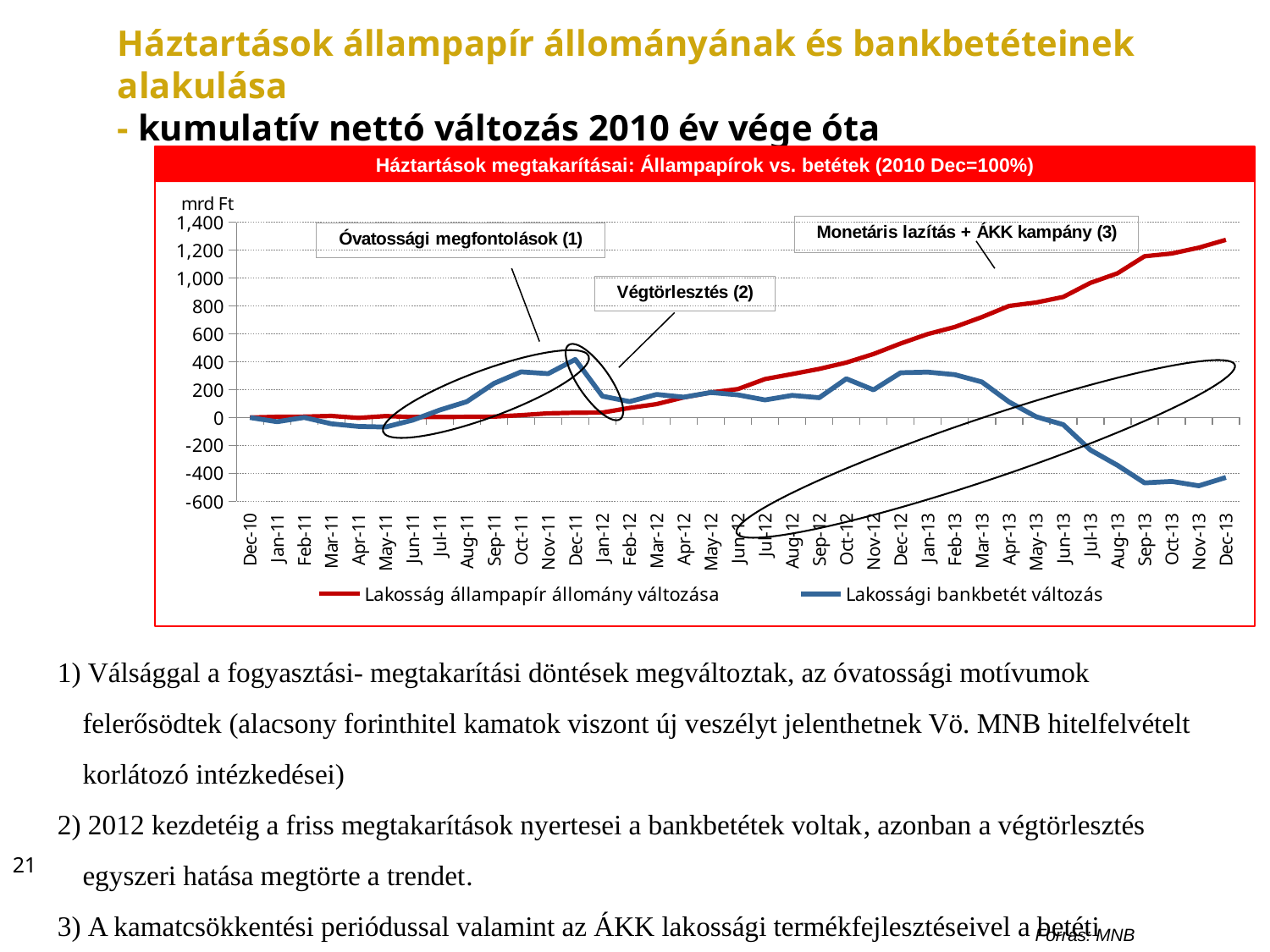
What is the title of the chart? Háztartások megtakarításai: Állampapírok vs. betétek (2010 Dec=100%) Is the value of 'Lakosság állampapír állomány változása' at Dec-13 greater or less than 1,200? greater What unit is shown on the y axis of the chart? mrd Ft At Dec-13, which series has the higher value: 'Lakosság állampapír állomány változása' or 'Lakossági bankbetét változás'? Lakosság állampapír állomány változása At Dec-11, which series has the higher value: 'Lakosság állampapír állomány változása' or 'Lakossági bankbetét változás'? Lakossági bankbetét változás Does the 'Lakosság állampapír állomány változása' series rise or fall from Dec-10 to Dec-13? rise Is the value of 'Lakossági bankbetét változás' at Nov-13 greater or less than -400? less How many series does the legend list? 2 What kind of chart is shown on the slide? line chart Is the value of 'Lakossági bankbetét változás' at Oct-11 greater or less than 200? greater How many monthly points are plotted along the x axis, from Dec-10 to Dec-13? 37